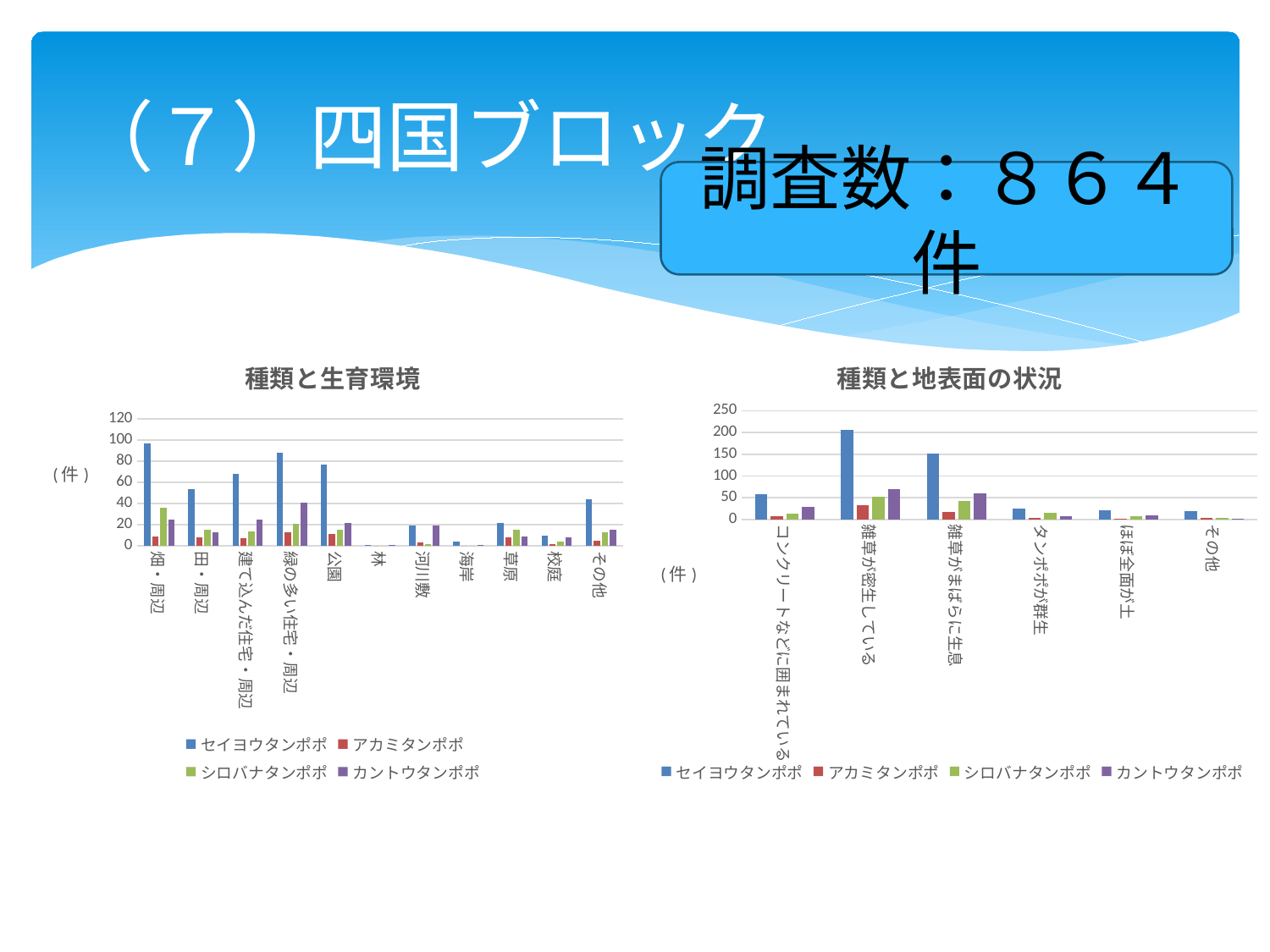
In the right chart 種類と地表面の状況, is the value for セイヨウタンポポ in 雑草がまばらに生息 greater or less than 100? greater In the left chart 種類と生育環境, how many series does the legend list? 4 In the right chart 種類と地表面の状況, is the value for セイヨウタンポポ in 雑草が密生している greater or less than 150? greater In the left chart 種類と生育環境, is the value for セイヨウタンポポ in 畑・周辺 greater or less than 80? greater In the right chart 種類と地表面の状況, which category has the highest value for セイヨウタンポポ? 雑草が密生している What kind of chart is the left chart titled 種類と生育環境? bar chart In the left chart 種類と生育環境, which is larger for セイヨウタンポポ: 公園 or 田・周辺? 公園 In the left chart 種類と生育環境, which category has the highest value for セイヨウタンポポ? 畑・周辺 In the right chart 種類と地表面の状況, how many categories are shown on the x axis? 6 In the left chart 種類と生育環境, how many categories are shown on the x axis? 11 In the right chart 種類と地表面の状況, which is larger for セイヨウタンポポ: コンクリートなどに囲まれている or タンポポが群生? コンクリートなどに囲まれている